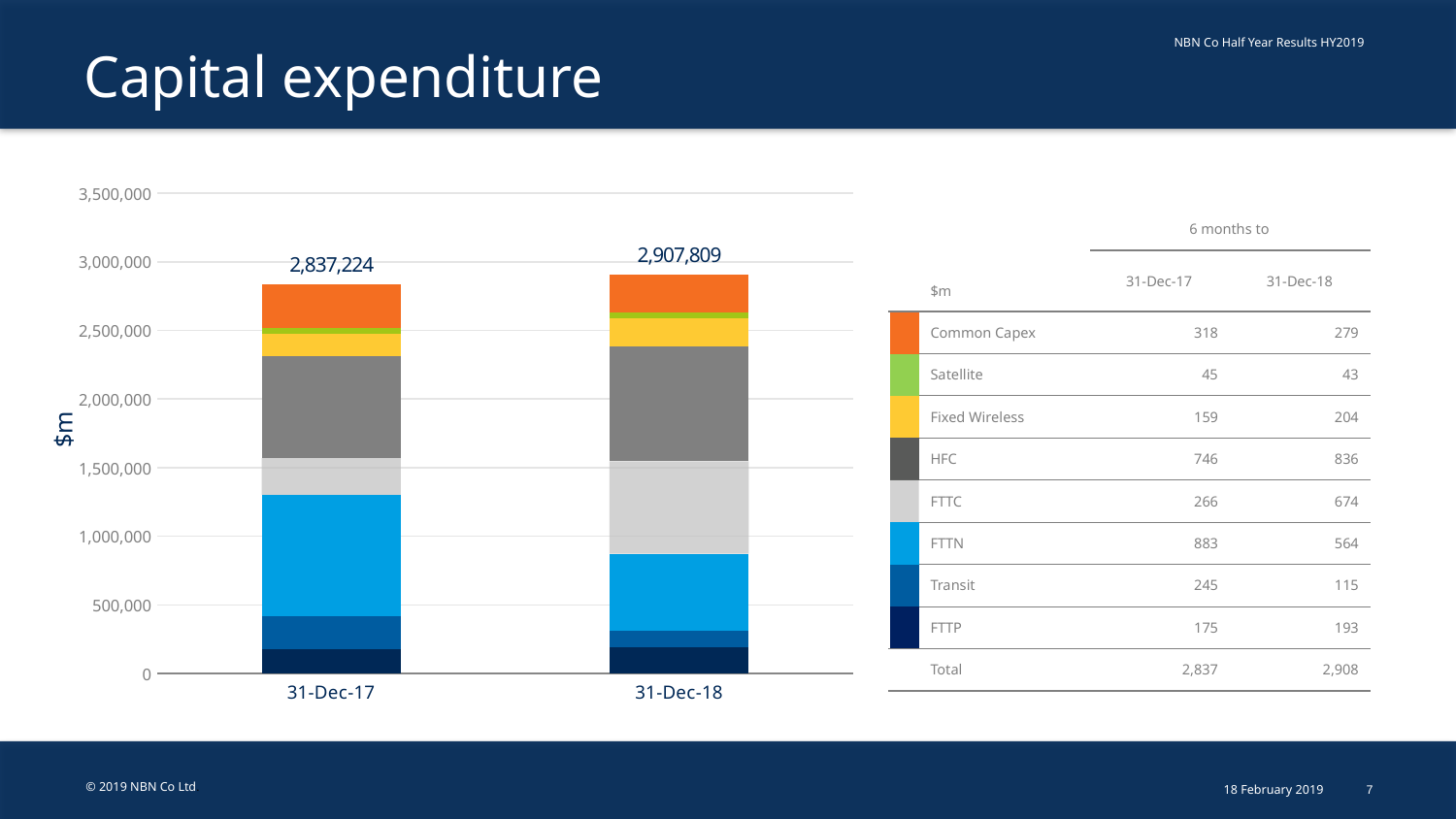
According to the table, which category had the largest capital expenditure in the 6 months to 31-Dec-17? FTTN Does total capital expenditure rise or fall from 31-Dec-17 to 31-Dec-18? rise What type of chart is shown on the slide? stacked bar chart According to the table, what was HFC capital expenditure ($m) for the 6 months to 31-Dec-18? 836 What is the total value labelled on the 31-Dec-18 bar? 2,907,809 What is the label on the vertical axis of the chart? $m How many bars are plotted in the chart? 2 Which bar has the higher total, 31-Dec-17 or 31-Dec-18? 31-Dec-18 What is the total value labelled on the 31-Dec-17 bar? 2,837,224 What is the difference between the labelled totals of the 31-Dec-18 and 31-Dec-17 bars? 70,585 Is the total for the 31-Dec-17 bar greater or less than 3,000,000? less How many capex categories (series) are stacked in each bar, according to the table legend? 8